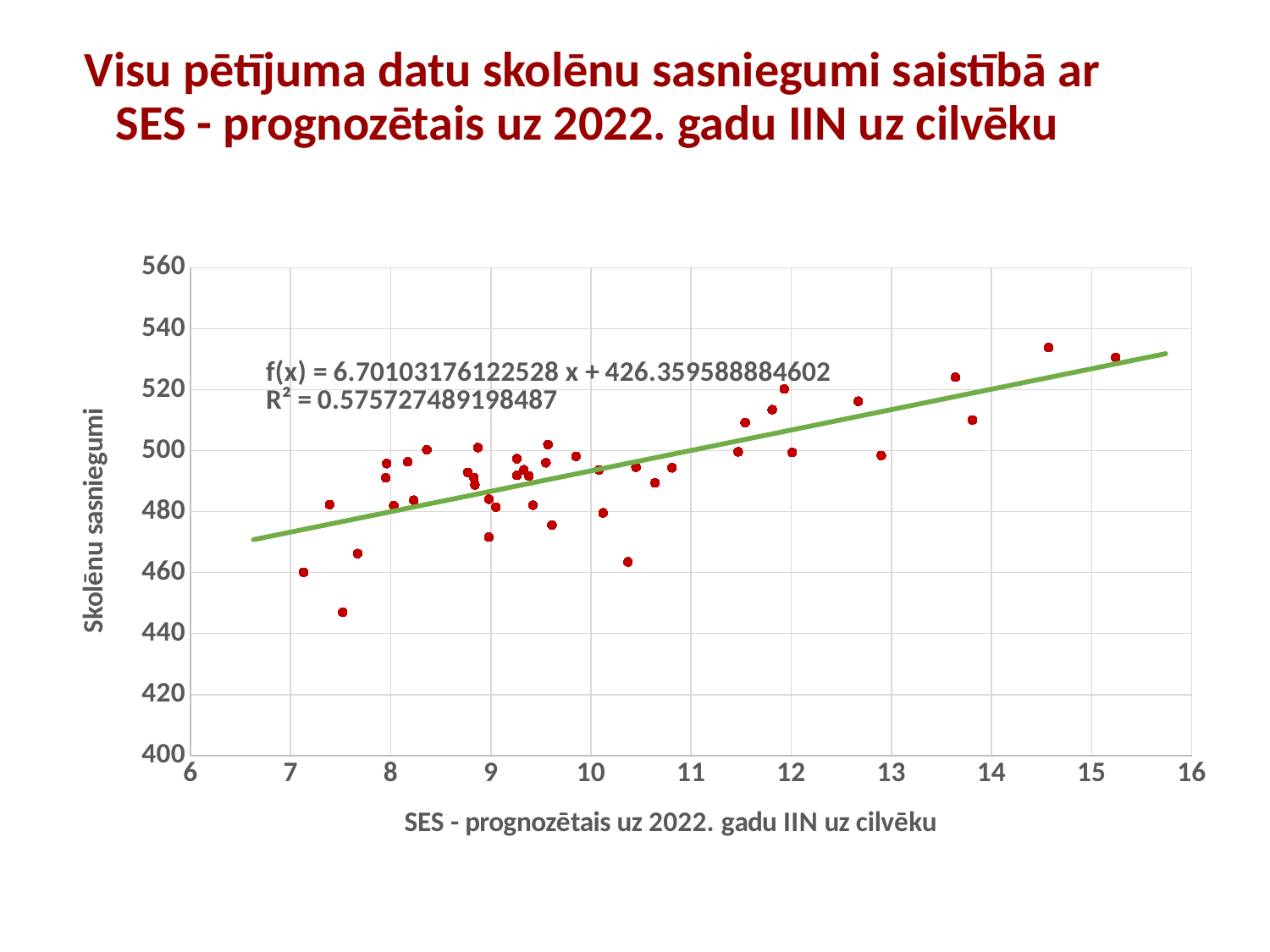
Is the trendline value at x = 15 greater or less than 520? greater Is the highest plotted point on the chart greater or less than 520? greater What is the intercept in the trendline equation f(x) printed on the chart? 426.359588884602 Is the lowest plotted point on the chart greater or less than 460? less What is the R² value printed on the chart? 0.575727489198487 What is the title of the chart's x axis? SES - prognozētais uz 2022. gadu IIN uz cilvēku Do the plotted values generally rise or fall as SES increases along the x axis? Rise What is the title of the chart's y axis? Skolēnu sasniegumi What kind of chart is shown on the slide? Scatter chart with a trendline What is the slope of the trendline equation printed on the chart? 6.70103176122528